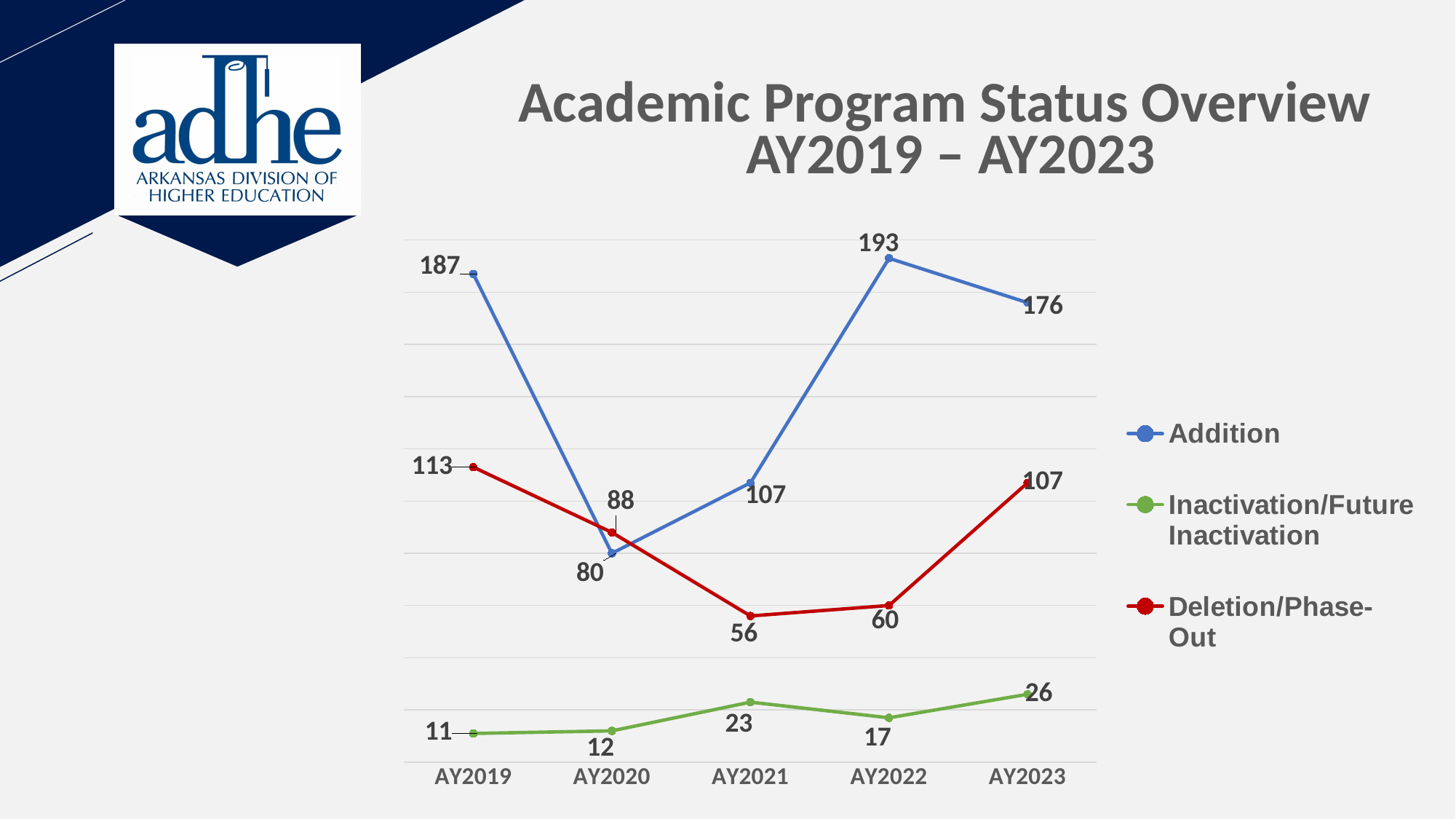
What is the value for Addition in AY2022? 193 What kind of chart is shown on the slide? Line chart Which is larger in AY2020: Addition or Deletion/Phase-Out? Deletion/Phase-Out What is the value for Deletion/Phase-Out in AY2019? 113 How many academic years are shown on the x axis? 5 Does the Inactivation/Future Inactivation series rise or fall from AY2022 to AY2023? Rise In which academic year is the Addition series at its lowest? AY2020 What colour is the line for Deletion/Phase-Out? Red In which academic year is the Deletion/Phase-Out series at its highest? AY2019 What is the difference between the Addition values in AY2022 and AY2023? 17 What is the value for Inactivation/Future Inactivation in AY2021? 23 How many series does the legend list? 3